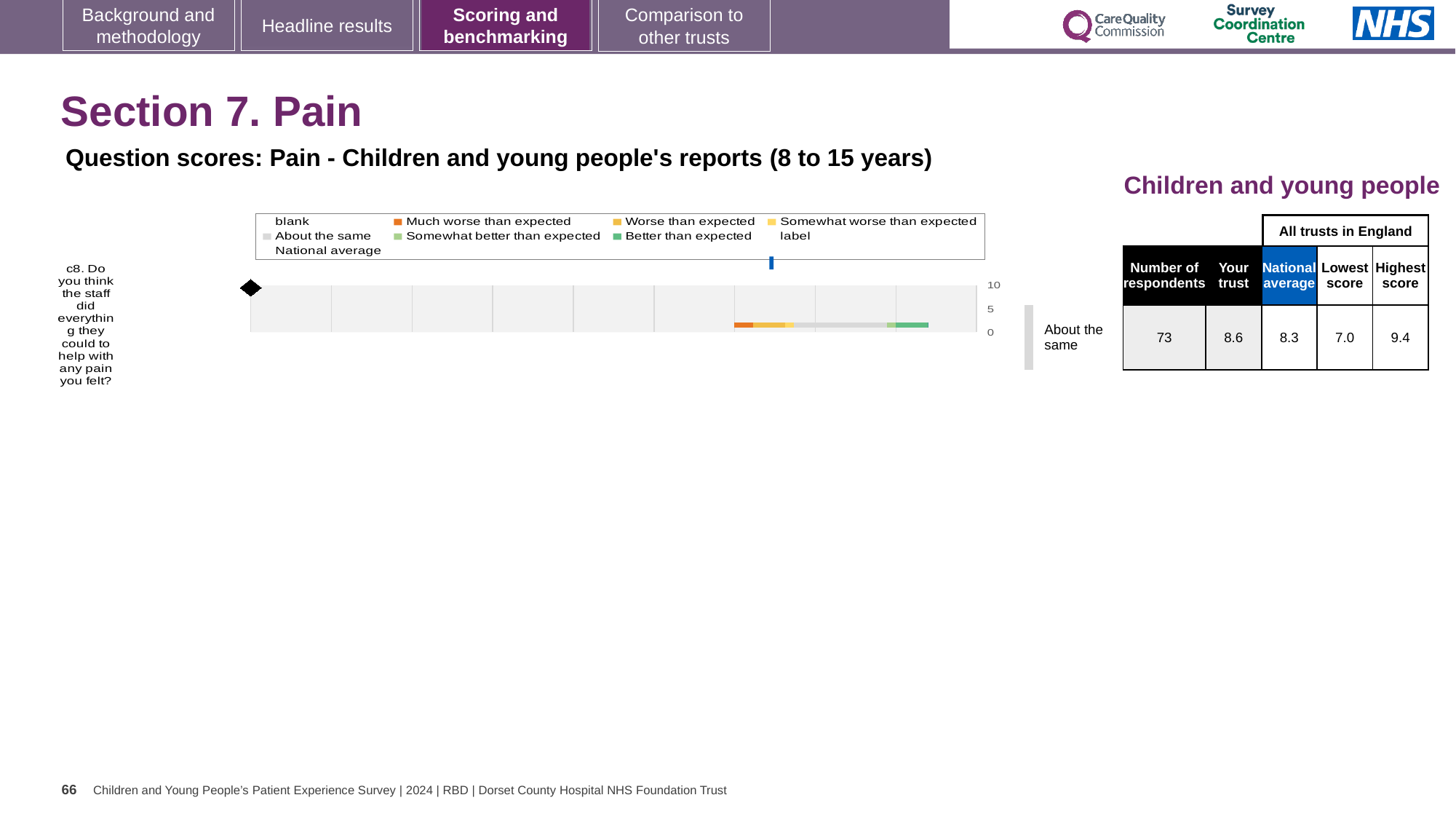
What is the difference between the trust's score and the national average for question c8? 0.3 What kind of chart is shown on the slide for question c8? bar chart What is the highest score among all trusts in England for question c8? 9.4 What is the highest value shown on the chart's score axis? 10 What is the lowest score among all trusts in England for question c8? 7.0 How many survey questions are plotted in the chart on this slide? 1 Which survey question is plotted in the chart? c8. Do you think the staff did everything they could to help with any pain you felt? What is the national average score for question c8 about staff helping with pain? 8.3 Which is larger for question c8: the trust's score or the national average? the trust's score How many respondents answered question c8 for this trust? 73 How is the trust's result for question c8 categorised relative to expectations? About the same What is the trust's score for question c8 about staff helping with pain? 8.6